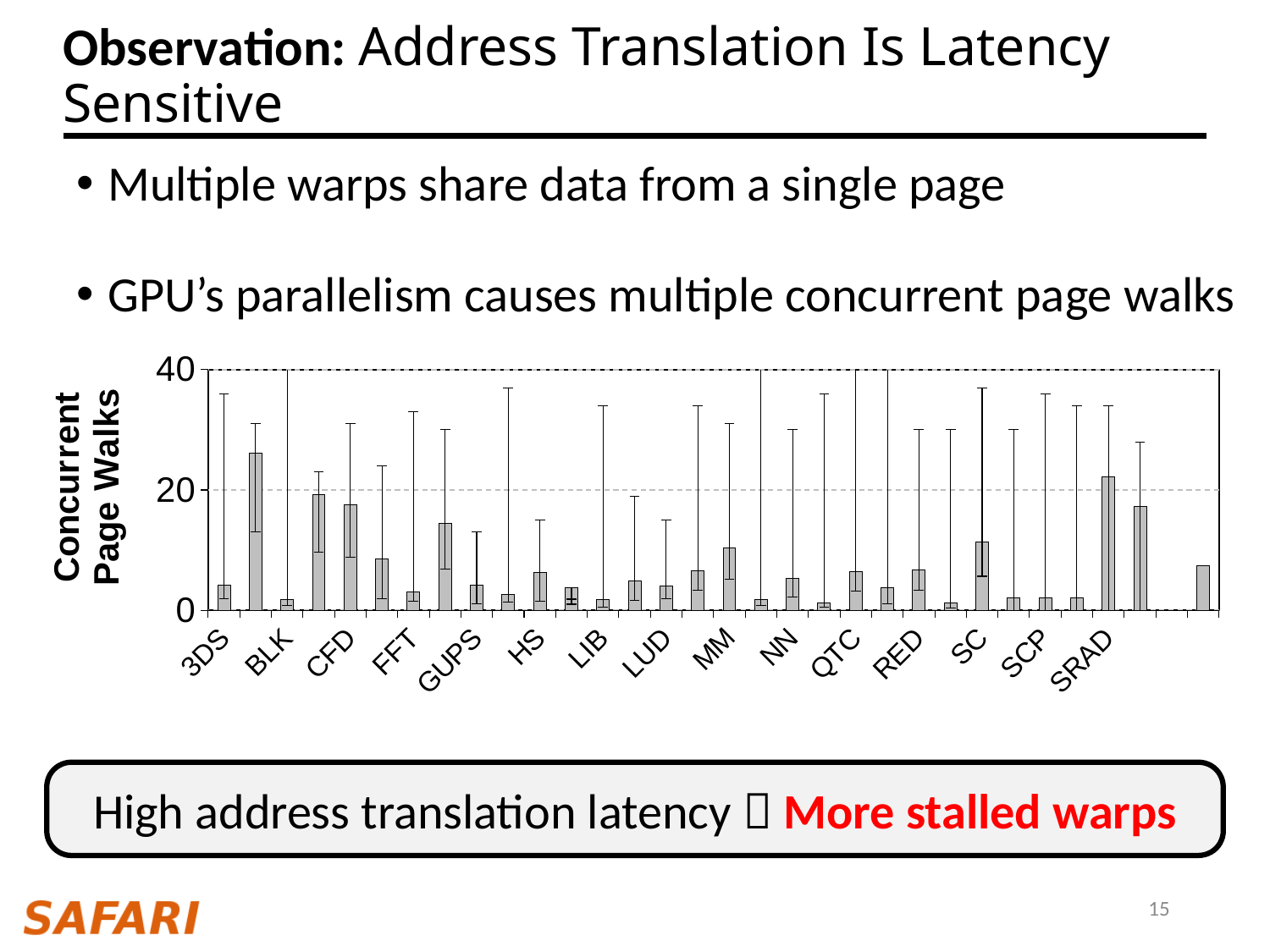
Which category label appears last (rightmost) on the x axis of the chart? SRAD What is the y-axis title of the chart? Concurrent Page Walks Is the tallest bar in the chart greater or less than 20 concurrent page walks? greater How many category labels are shown along the x axis of the chart? 15 What kind of chart is shown on the slide? bar chart Which category label appears first (leftmost) on the x axis of the chart? 3DS Is the tallest bar in the chart greater or less than 40 concurrent page walks? less